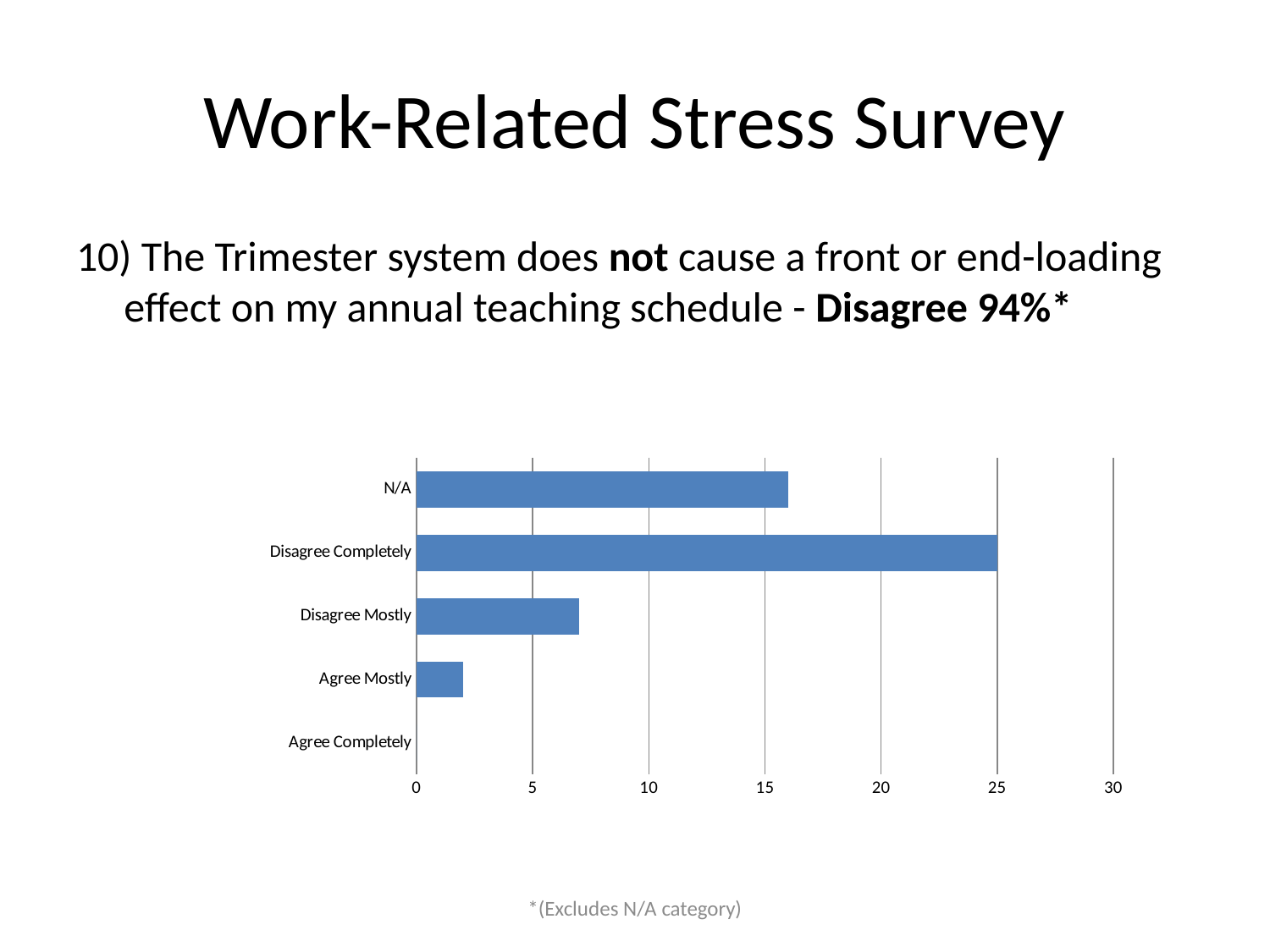
Is the value for N/A greater or less than 20? less What kind of chart is shown on the slide? bar chart How many categories are shown on the chart? 5 Which is larger, the value for N/A or the value for Disagree Mostly? N/A Which category has the highest value? Disagree Completely What is the value for Agree Completely? 0 Is the value for Disagree Mostly greater or less than 5? greater Is the value for N/A greater or less than 15? greater What is the value for Disagree Completely? 25 What colour are the bars in the chart? blue Which category has the lowest value? Agree Completely